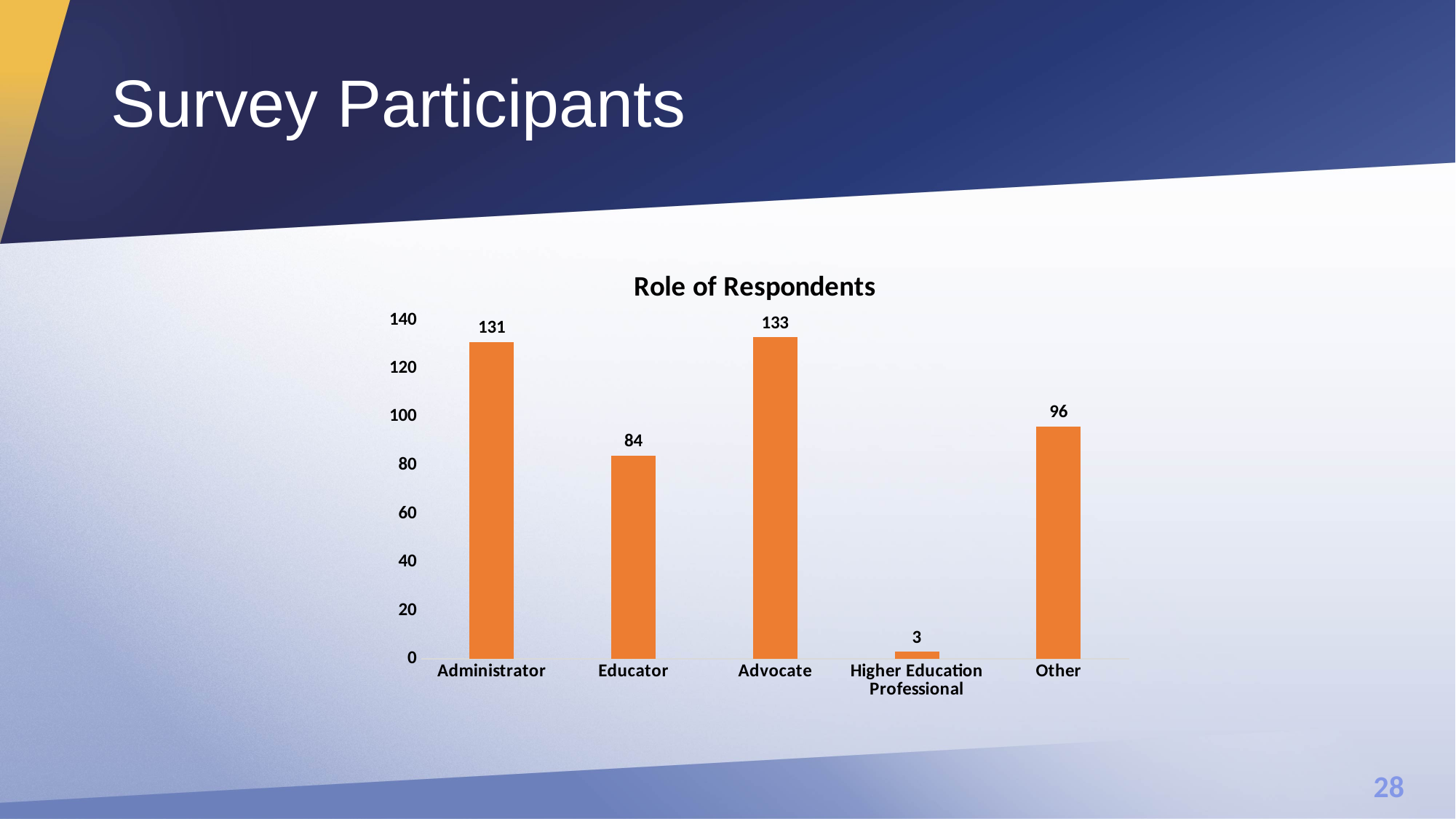
How many roles are shown on the x axis? 5 What is the value for Other? 96 Is the value for Other greater or less than 100? less What is the value for Educator? 84 What is the value for Administrator? 131 What is the value for Higher Education Professional? 3 Which role has the lowest number of respondents? Higher Education Professional What kind of chart is shown on the slide? Bar chart What is the difference between the values for Other and Educator? 12 Which is larger, the value for Other or the value for Educator? Other Which role has the highest number of respondents? Advocate What is the difference between the values for Advocate and Administrator? 2